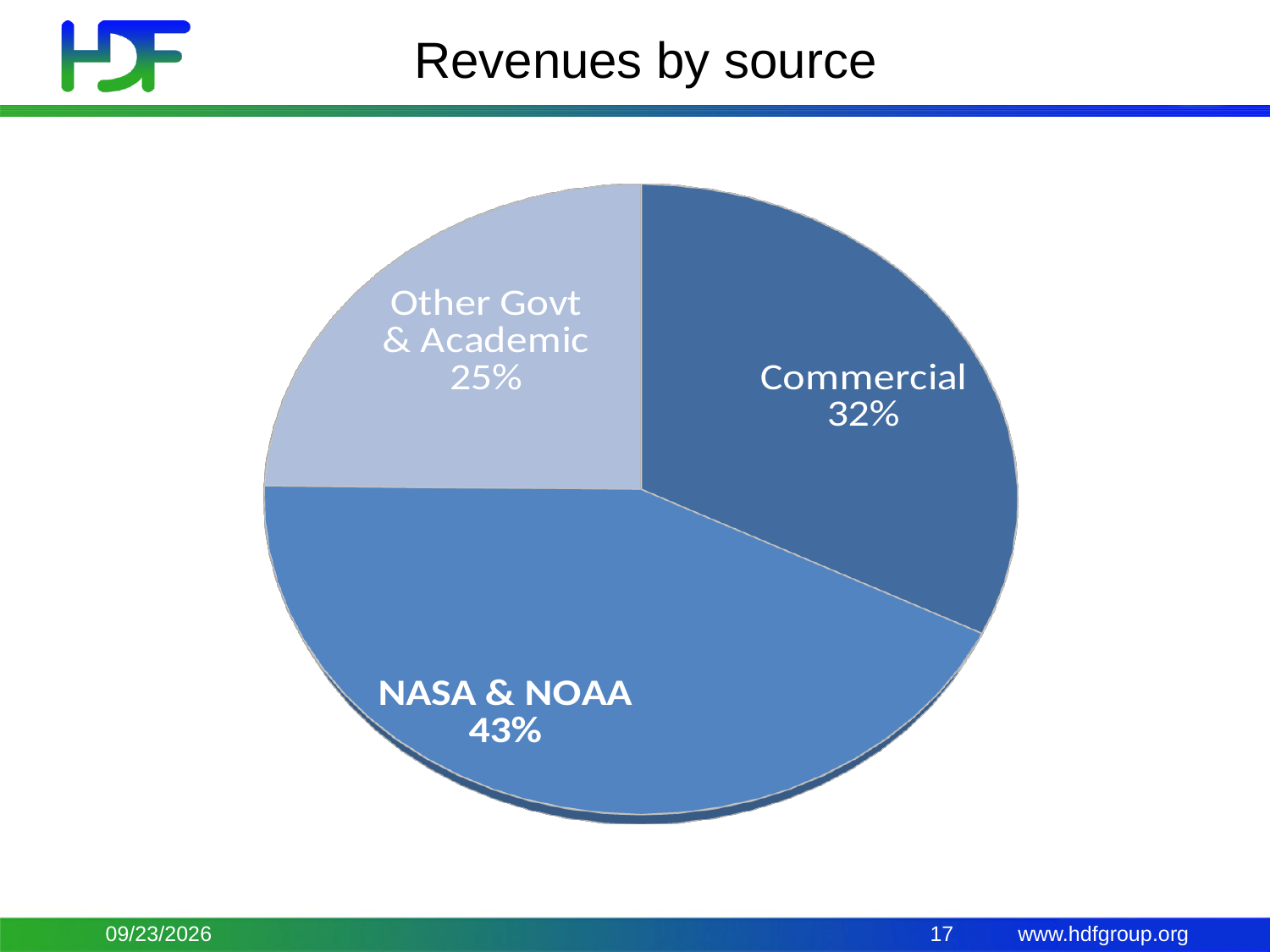
What share of revenues comes from Commercial sources? 32% Which is larger, the Commercial share or the Other Govt & Academic share? Commercial What is the difference in percentage points between the Commercial share and the Other Govt & Academic share? 7 What is the difference in percentage points between the NASA & NOAA share and the Commercial share? 11 Which revenue source has the largest share? NASA & NOAA What share of revenues comes from Other Govt & Academic? 25% What share of revenues comes from NASA & NOAA? 43% How many slices does the pie chart have? 3 Which revenue source has the smallest share? Other Govt & Academic What is the combined share of NASA & NOAA and Commercial revenues? 75% What is the title of the slide containing the pie chart? Revenues by source What kind of chart is shown on the slide? pie chart